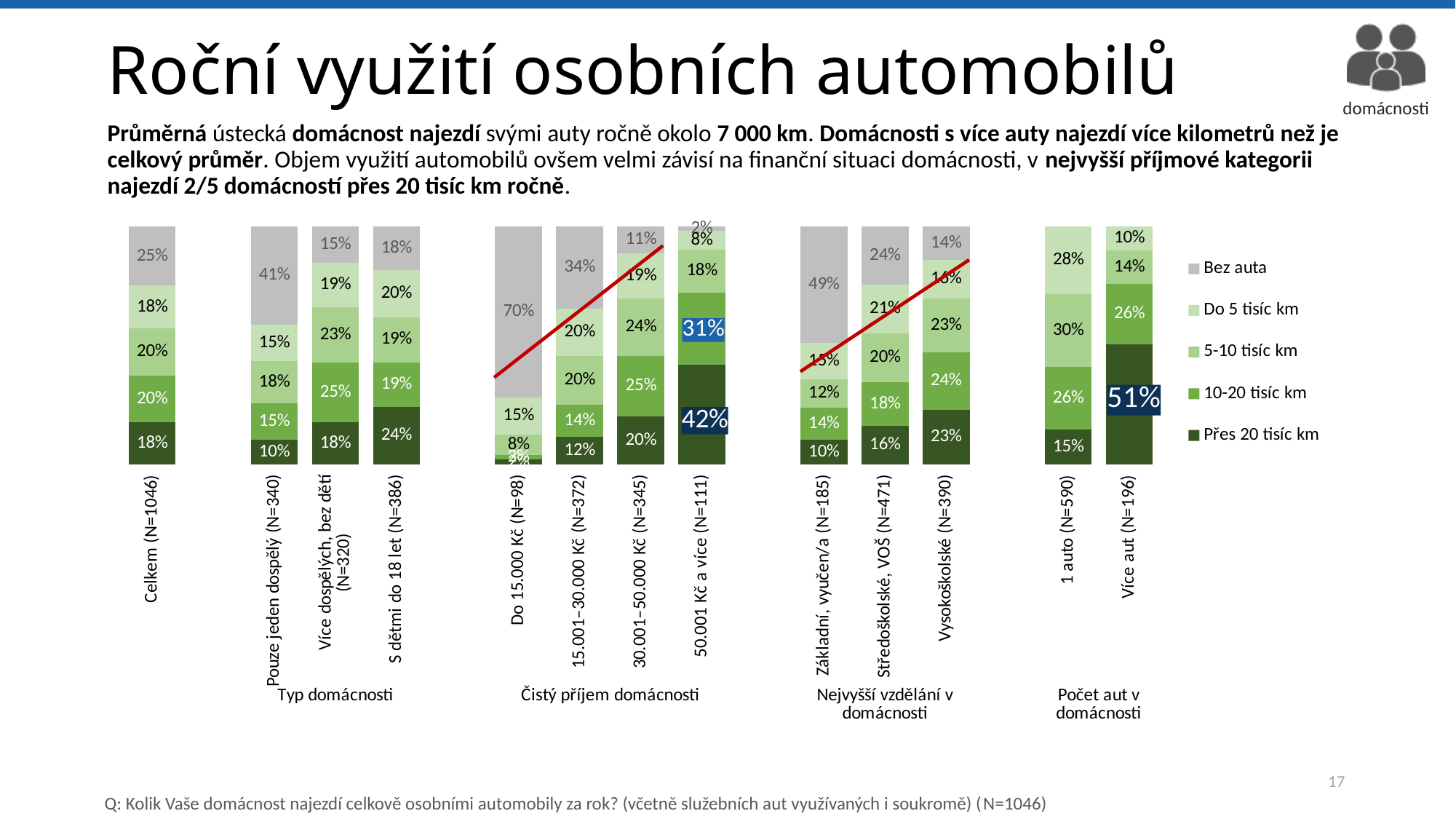
Among the income categories (Čistý příjem domácnosti), which bar has the highest 'Přes 20 tisíc km' share? 50.001 Kč a více (N=111) What percentage of households in the Celkem (N=1046) bar fall into the 'Přes 20 tisíc km' category? 18% What is the 'Přes 20 tisíc km' value for the 'Více aut (N=196)' bar? 51% How many series does the legend list? 5 What is the difference in the 'Přes 20 tisíc km' share between 'Více aut (N=196)' and '1 auto (N=590)'? 36 percentage points What kind of chart is shown on the slide? Stacked bar chart Which has a larger 'Bez auta' share: 'Pouze jeden dospělý (N=340)' or 'S dětmi do 18 let (N=386)'? Pouze jeden dospělý (N=340) What is the '10-20 tisíc km' value for the '50.001 Kč a více (N=111)' bar? 31% What is the 'Bez auta' share for the 'Do 15.000 Kč (N=98)' bar? 70% What colour represents the 'Bez auta' series in the legend? Grey Among the education categories (Nejvyšší vzdělání v domácnosti), which bar has the lowest 'Bez auta' share? Vysokoškolské (N=390) What is the 'Bez auta' share for the 'Pouze jeden dospělý (N=340)' bar? 41%